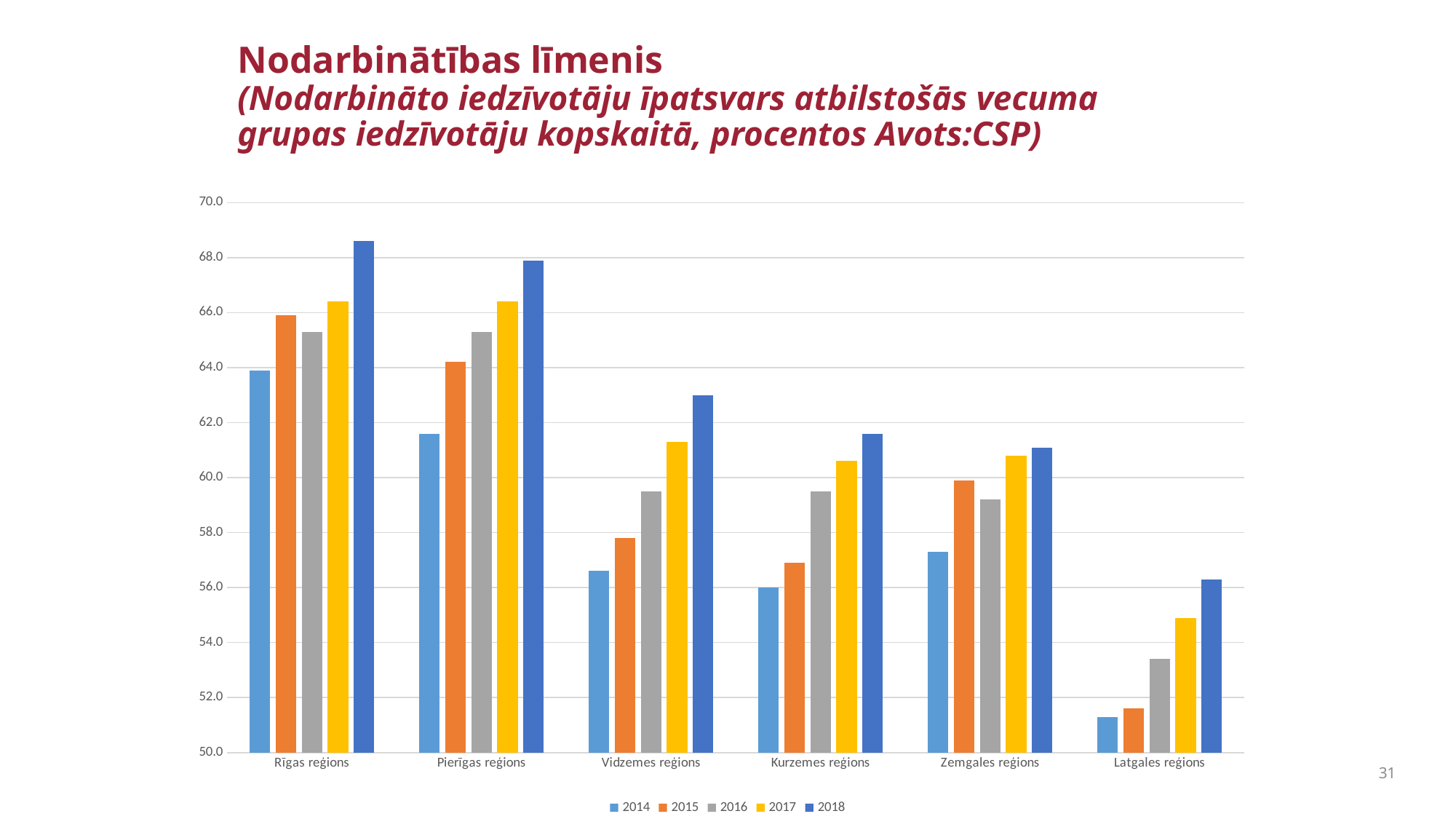
How many series does the legend list? 5 Is the value for Latgales reģions in 2014 greater or less than 52.0? less Is the value for Zemgales reģions in 2014 greater or less than 58.0? less Which year does the dark blue bar represent in the legend? 2018 What kind of chart is shown on the slide? bar chart Which is larger, the 2015 value for Zemgales reģions or the 2015 value for Kurzemes reģions? Zemgales reģions Do the values for Latgales reģions rise or fall from 2014 to 2018? rise Which region has the lowest value for 2014? Latgales reģions How many regions are shown on the x axis of the chart? 6 Which region has the highest value for 2018? Rīgas reģions Is the value for Rīgas reģions in 2018 greater or less than 68.0? greater